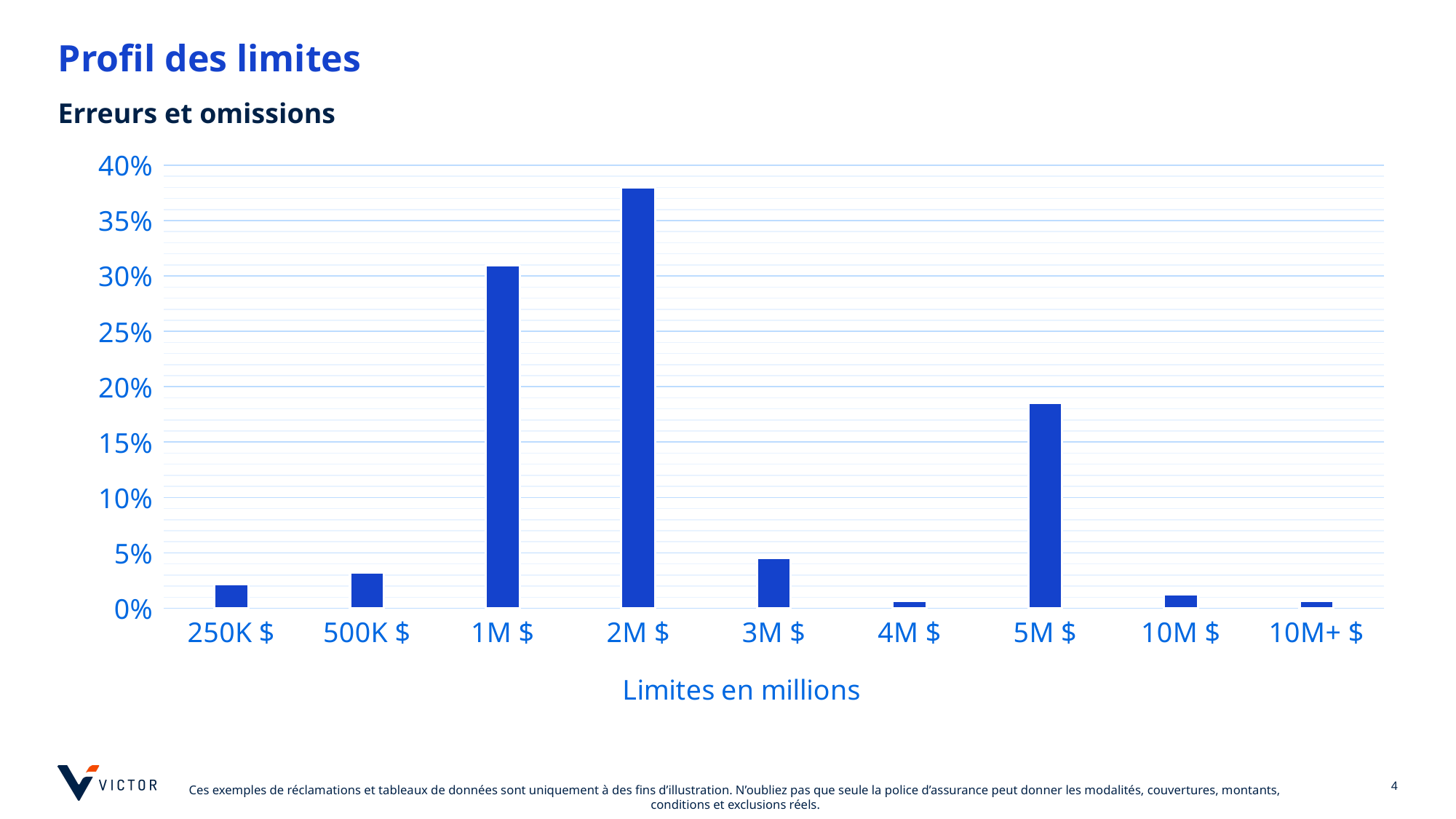
Is the value for 5M $ greater or less than 20%? less How many limit categories are shown on the x axis? 9 Which is larger, the value for 3M $ or the value for 4M $? 3M $ What is the label of the x axis? Limites en millions Which is larger, the value for 1M $ or the value for 5M $? 1M $ What is the subtitle shown above the chart? Erreurs et omissions Is the value for 250K $ greater or less than 5%? less Is the value for 1M $ greater or less than 30%? greater Which limit category has the highest bar? 2M $ What kind of chart is shown on the slide? bar chart